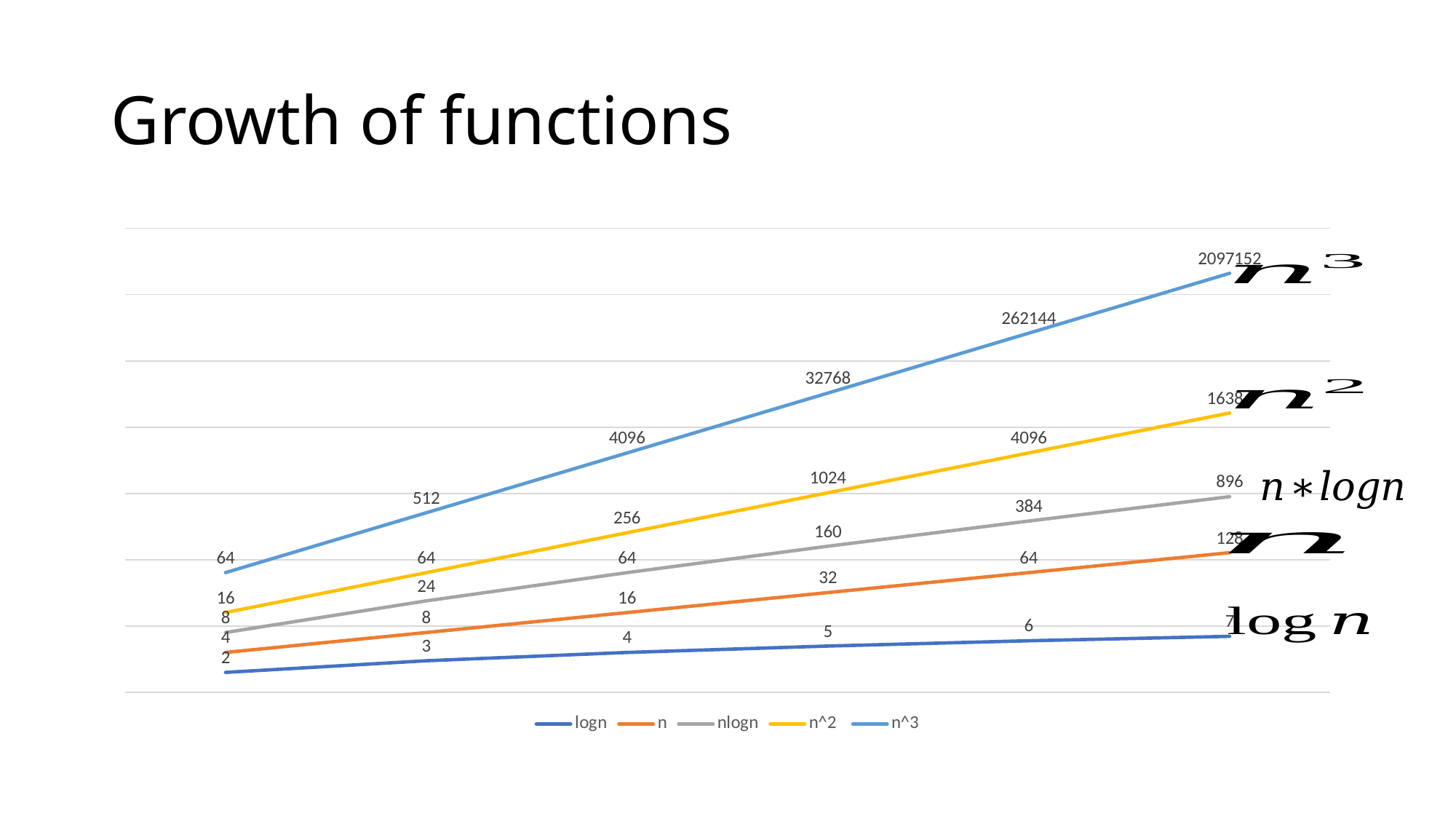
What is the first value of the logn series? 2 How many series does the legend list? 5 What is the fourth value of the n^2 series? 1024 Which series has the highest value at the rightmost point? n^3 How many data points does each line have? 6 What is the difference between the last and the fifth value of the n^3 series? 1835008 What kind of chart is shown on the slide? line chart What is the fifth value of the n^3 series? 262144 Which series has the lowest value at the rightmost point? logn What is the last (rightmost) value of the nlogn series? 896 What is the last (rightmost) value of the n^3 series? 2097152 At the fifth point, which is larger: the n^2 value or the nlogn value? n^2